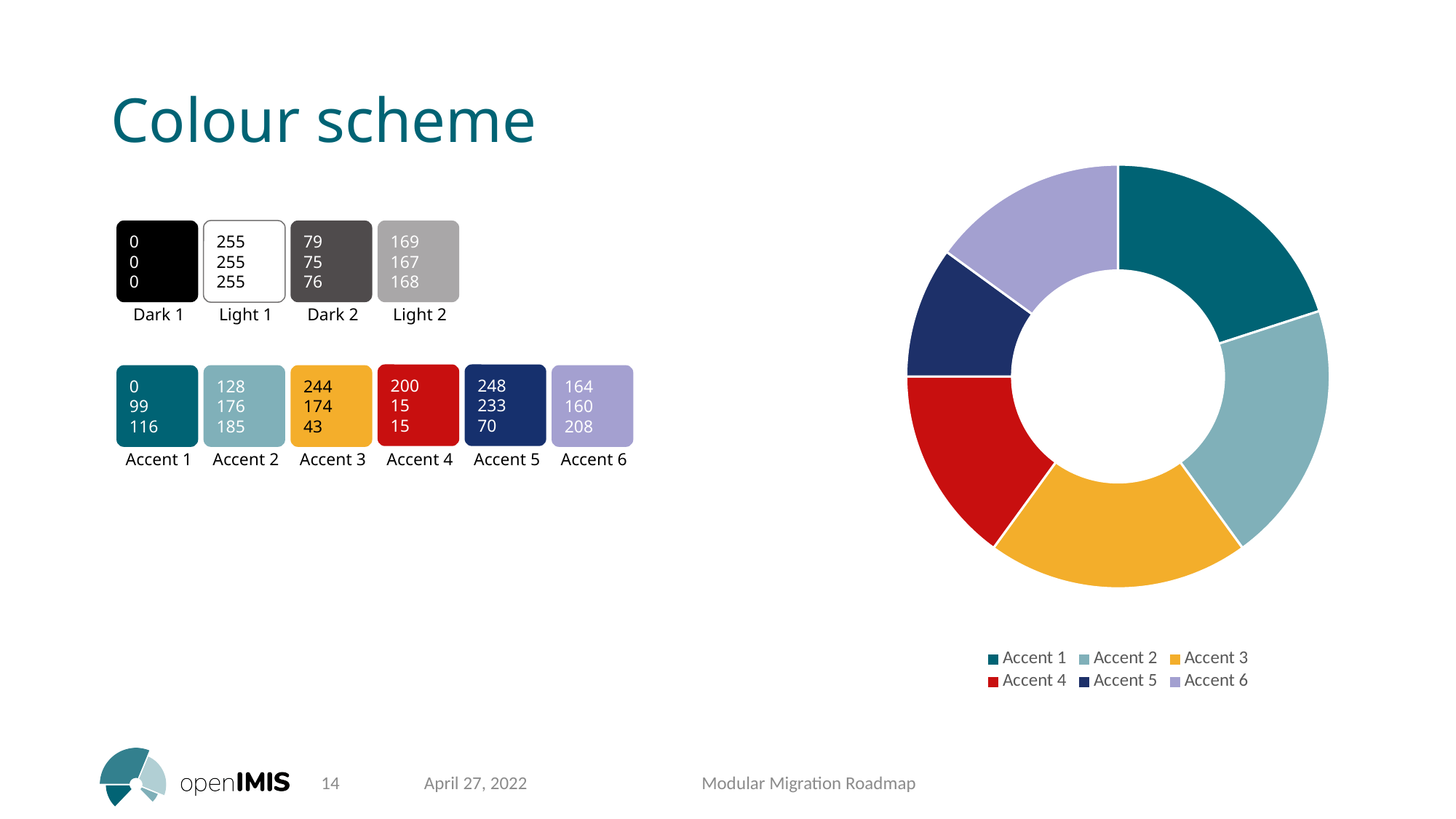
Which legend entry in the doughnut chart is shown in red? Accent 4 Which slice is larger in the doughnut chart, Accent 1 or Accent 5? Accent 1 Which slice is larger in the doughnut chart, Accent 2 or Accent 5? Accent 2 Which slice is larger in the doughnut chart, Accent 3 or Accent 6? Accent 3 What kind of chart is shown on the slide? doughnut chart How many entries does the legend of the doughnut chart list? 6 How many slices does the doughnut chart have? 6 What colour is the Accent 3 slice in the doughnut chart? yellow/orange